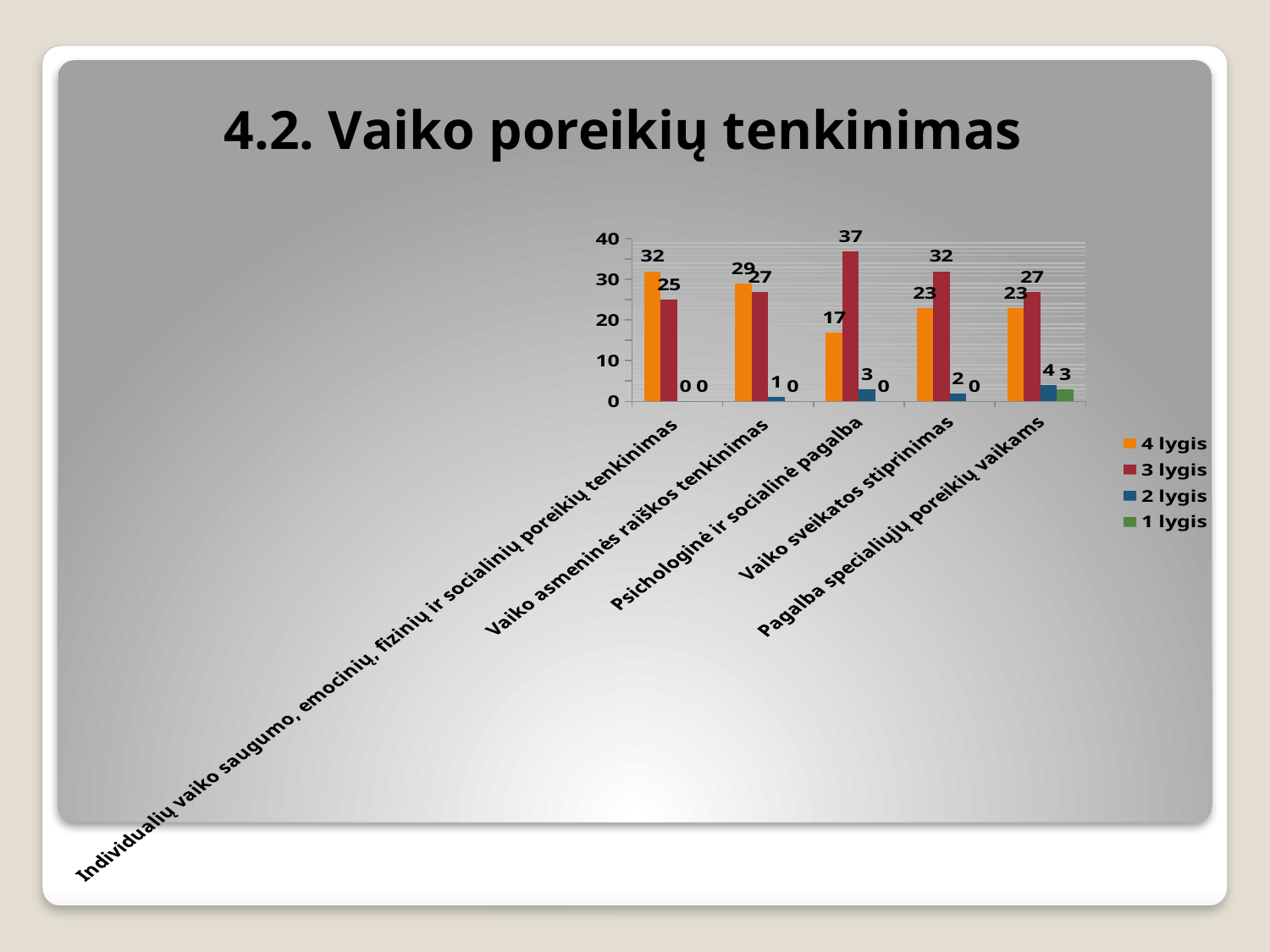
What is the difference between the "3 lygis" and "4 lygis" values for "Vaiko sveikatos stiprinimas"? 9 What type of chart is shown on the slide? Bar chart How many series does the chart legend list? 4 What is the value of the "2 lygis" series for "Pagalba specialiųjų poreikių vaikams"? 4 What is the title of the slide containing the chart? 4.2. Vaiko poreikių tenkinimas Which category has the lowest value in the "4 lygis" series? Psichologinė ir socialinė pagalba For "Individualių vaiko saugumo, emocinių, fizinių ir socialinių poreikių tenkinimas", which is larger: the "4 lygis" value or the "3 lygis" value? 4 lygis What is the value of the "3 lygis" series for "Psichologinė ir socialinė pagalba"? 37 Which category has the highest value in the "3 lygis" series? Psichologinė ir socialinė pagalba How many categories are shown on the x axis of the chart? 5 What is the value of the "4 lygis" series for "Vaiko asmeninės raiškos tenkinimas"? 29 What is the value of the "1 lygis" series for "Pagalba specialiųjų poreikių vaikams"? 3